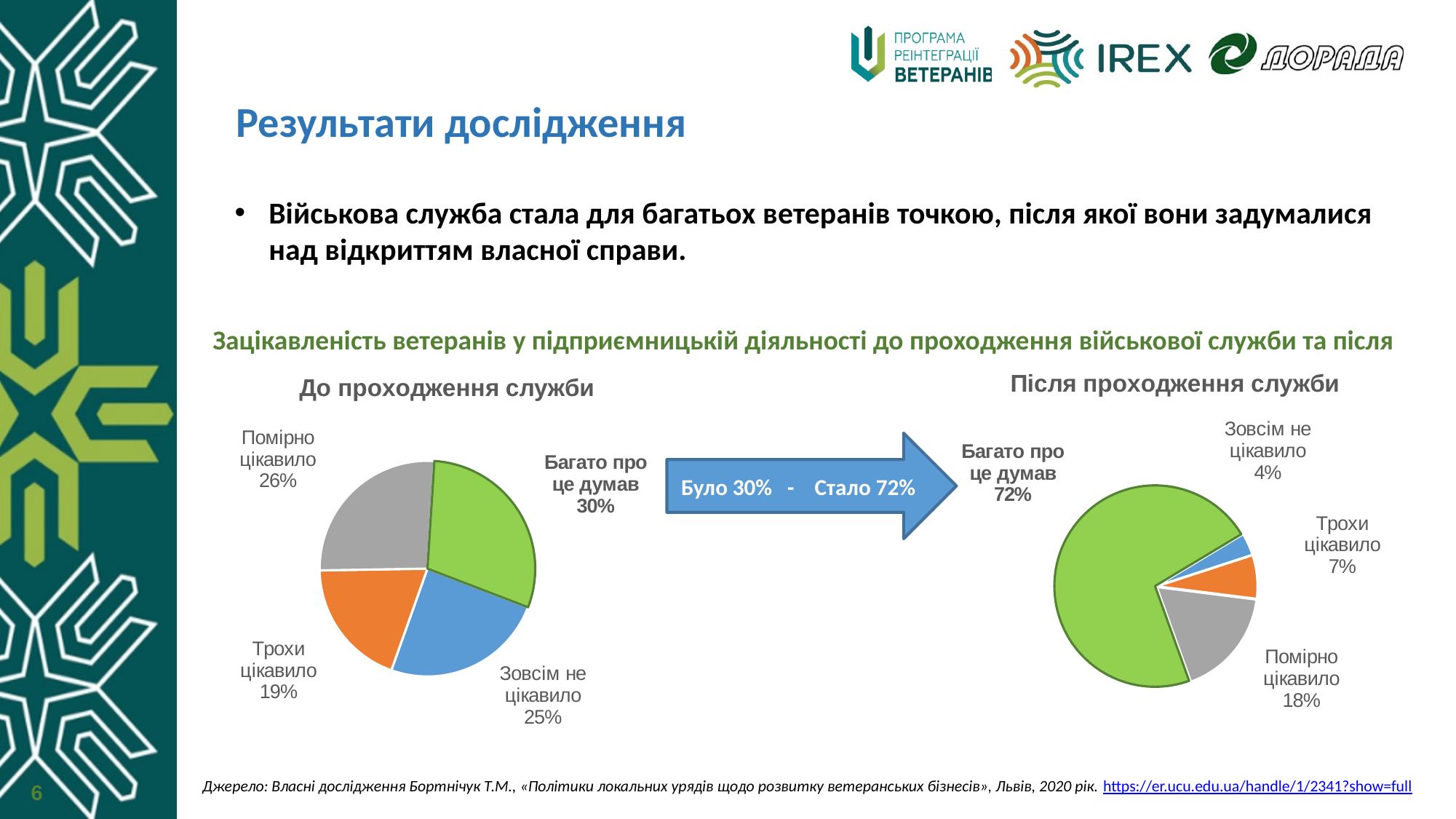
What text is shown in the arrow between the two charts? Було 30% - Стало 72% In the 'До проходження служби' chart, what share is labelled 'Багато про це думав'? 30% What is the difference between the 'Багато про це думав' share in the 'Після проходження служби' chart and in the 'До проходження служби' chart? 42% What type of chart is 'До проходження служби'? Pie chart How many categories does the 'Після проходження служби' chart show? 4 In the 'До проходження служби' chart, which is larger: 'Помірно цікавило' or 'Трохи цікавило'? Помірно цікавило In the 'Після проходження служби' chart, what share is labelled 'Зовсім не цікавило'? 4% In the 'Після проходження служби' chart, which category has the smallest slice? Зовсім не цікавило In the 'Після проходження служби' chart, what share is labelled 'Багато про це думав'? 72% In the 'До проходження служби' chart, which category has the smallest slice? Трохи цікавило In the 'Після проходження служби' chart, which category has the largest slice? Багато про це думав In the 'До проходження служби' chart, what share is labelled 'Помірно цікавило'? 26%